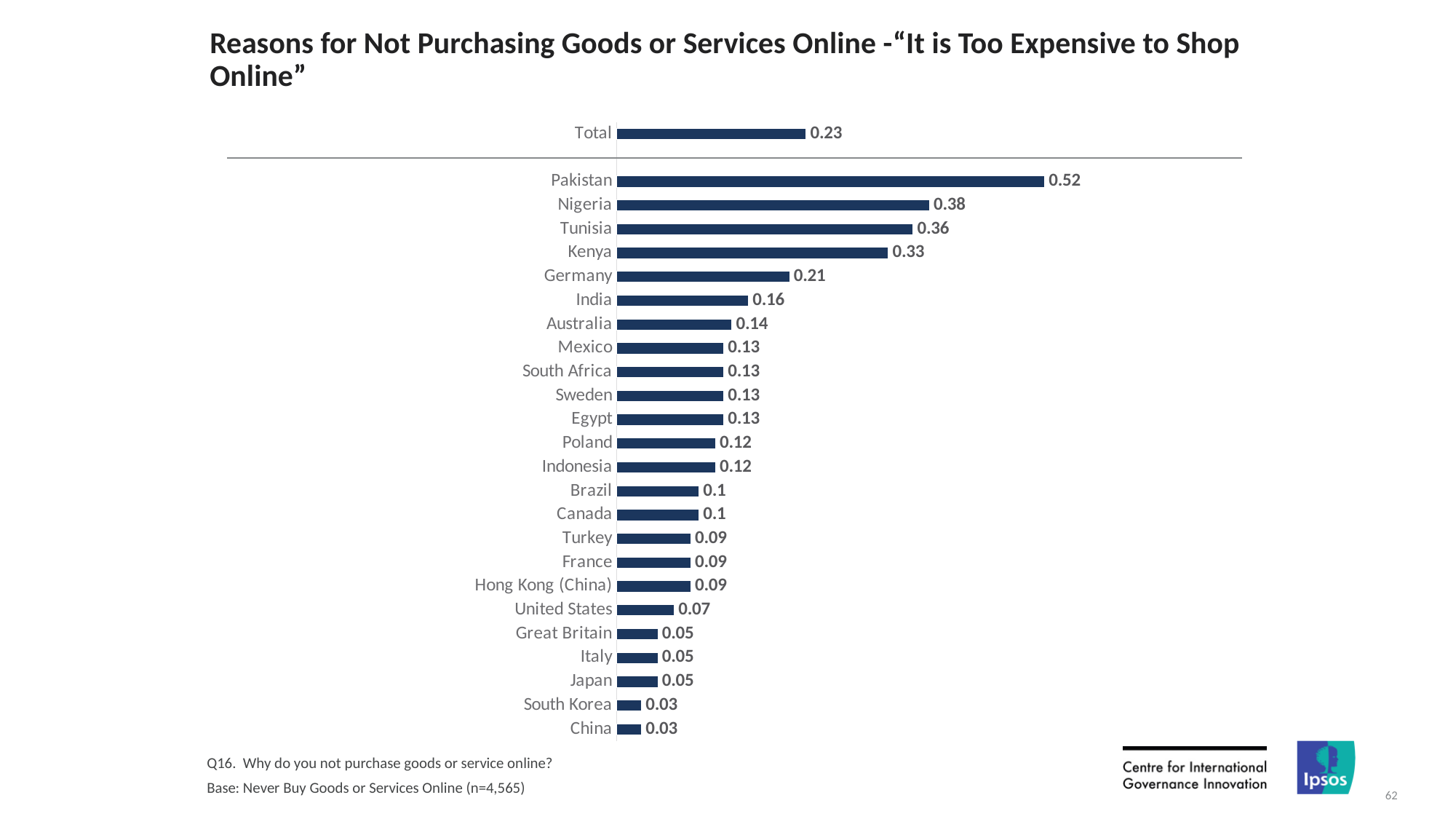
Which has a larger value, Australia or Brazil? Australia What is the value for Total? 0.23 What is the value for United States? 0.07 What is the value for Germany? 0.21 What is the title of the chart? Reasons for Not Purchasing Goods or Services Online - "It is Too Expensive to Shop Online" What kind of chart is shown on the slide? Bar chart Which has a larger value, Tunisia or Kenya? Tunisia What is the difference between the values for Pakistan and Nigeria? 0.14 What is the value for Pakistan? 0.52 How many countries are shown in the chart, excluding Total? 24 What is the difference between the values for Kenya and India? 0.17 Which country has the highest value? Pakistan